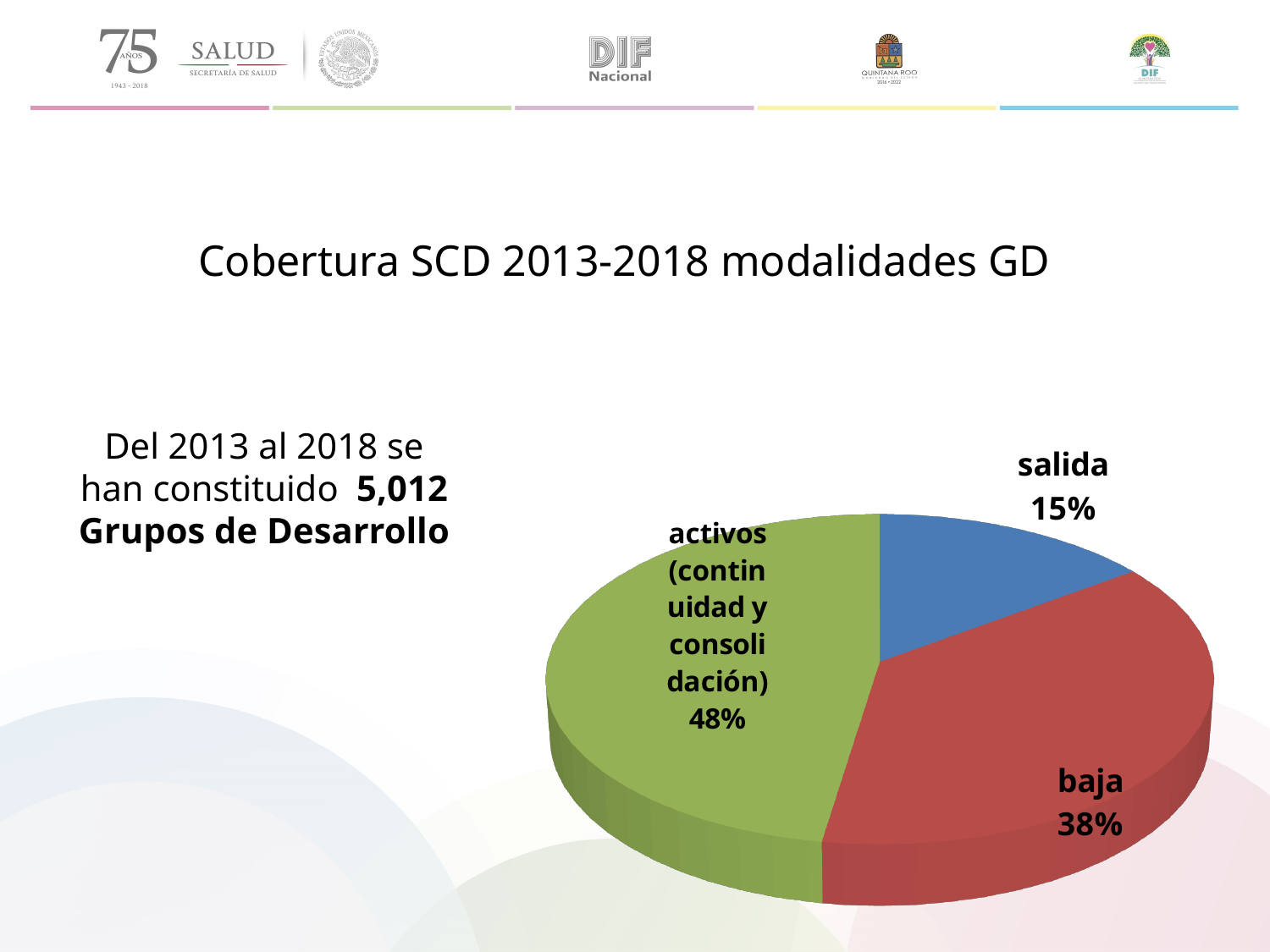
Which category has the smallest share of the pie? salida What is the difference in percentage points between the 'activos (continuidad y consolidación)' and 'baja' shares? 10 What share of the pie does the 'salida' slice represent? 15% What colour is the 'salida' slice? blue What kind of chart is shown on the slide? pie chart Which category has the largest share of the pie? activos (continuidad y consolidación) What is the difference in percentage points between the 'baja' and 'salida' shares? 23 What share of the pie does the 'activos (continuidad y consolidación)' slice represent? 48% What share of the pie does the 'baja' slice represent? 38% How many slices does the pie chart have? 3 What colour is the 'baja' slice? red Which is larger, the share for 'baja' or the share for 'salida'? baja